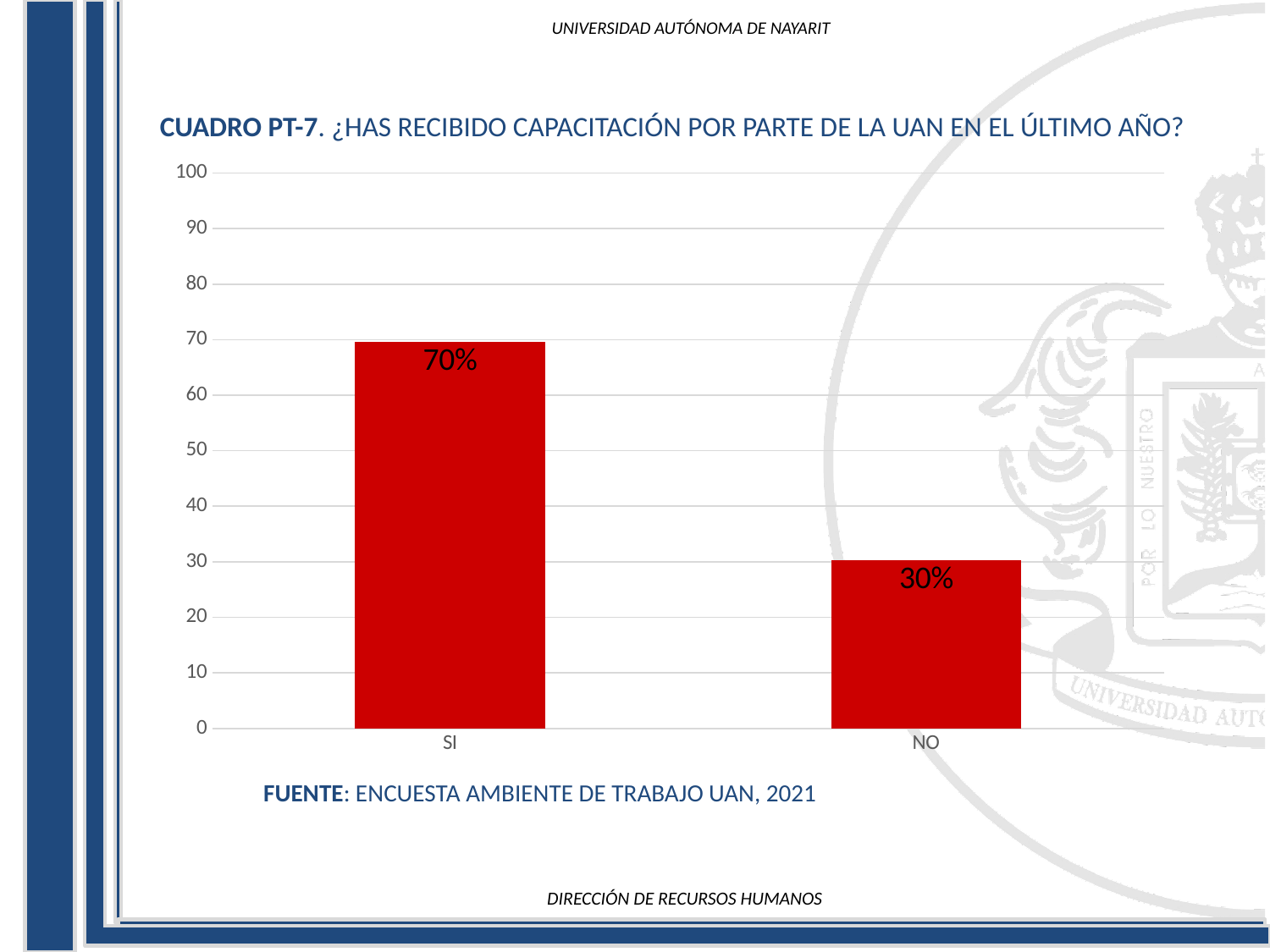
What is the value for SI? 70% Is the value for NO greater or less than 40? less Which category has the highest value? SI What kind of chart is shown on the slide? bar chart What colour are the bars in the chart? red What is the difference between the values for SI and NO? 40% Which category has the lowest value? NO Which is larger, the value for SI or the value for NO? SI Is the value for SI greater or less than 60? greater How many categories are shown on the x axis? 2 What is the title of the chart? CUADRO PT-7. ¿HAS RECIBIDO CAPACITACIÓN POR PARTE DE LA UAN EN EL ÚLTIMO AÑO? What is the value for NO? 30%